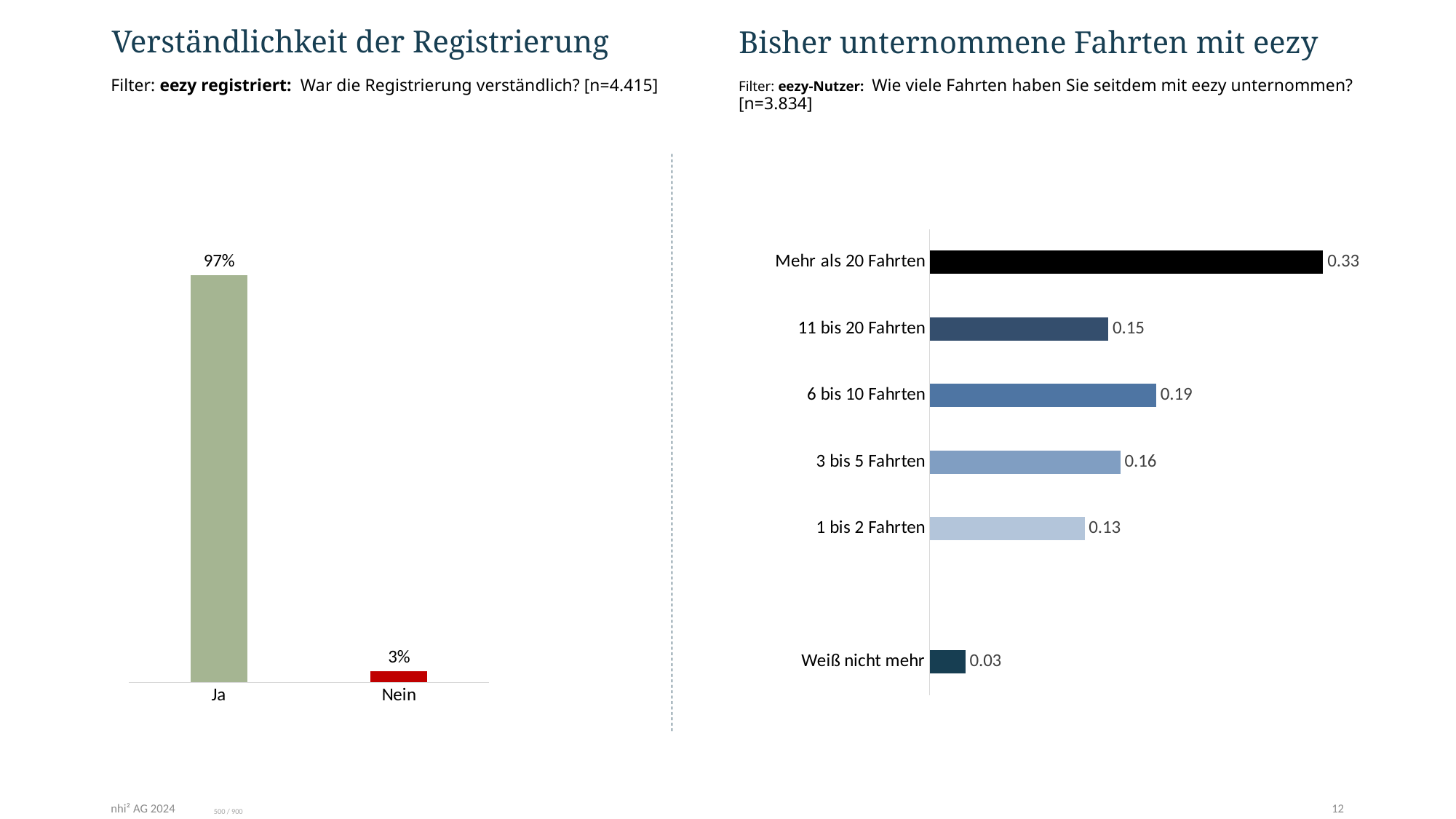
In the 'Bisher unternommene Fahrten mit eezy' chart, what is the value for 'Mehr als 20 Fahrten'? 0.33 In the 'Bisher unternommene Fahrten mit eezy' chart, which category has the highest value? Mehr als 20 Fahrten What kind of chart is the 'Verständlichkeit der Registrierung' chart? bar chart In the 'Verständlichkeit der Registrierung' chart, how many categories are shown? 2 In the 'Bisher unternommene Fahrten mit eezy' chart, what is the value for '6 bis 10 Fahrten'? 0.19 In the 'Bisher unternommene Fahrten mit eezy' chart, how many categories are shown? 6 In the 'Verständlichkeit der Registrierung' chart, what is the value for 'Ja'? 97% In the 'Verständlichkeit der Registrierung' chart, what is the value for 'Nein'? 3% In the 'Verständlichkeit der Registrierung' chart, what is the difference between the values for 'Ja' and 'Nein'? 94% In the 'Bisher unternommene Fahrten mit eezy' chart, what is the difference between 'Mehr als 20 Fahrten' and '1 bis 2 Fahrten'? 0.20 In the 'Bisher unternommene Fahrten mit eezy' chart, which category has the lowest value? Weiß nicht mehr In the 'Bisher unternommene Fahrten mit eezy' chart, which is larger: '11 bis 20 Fahrten' or '3 bis 5 Fahrten'? 3 bis 5 Fahrten